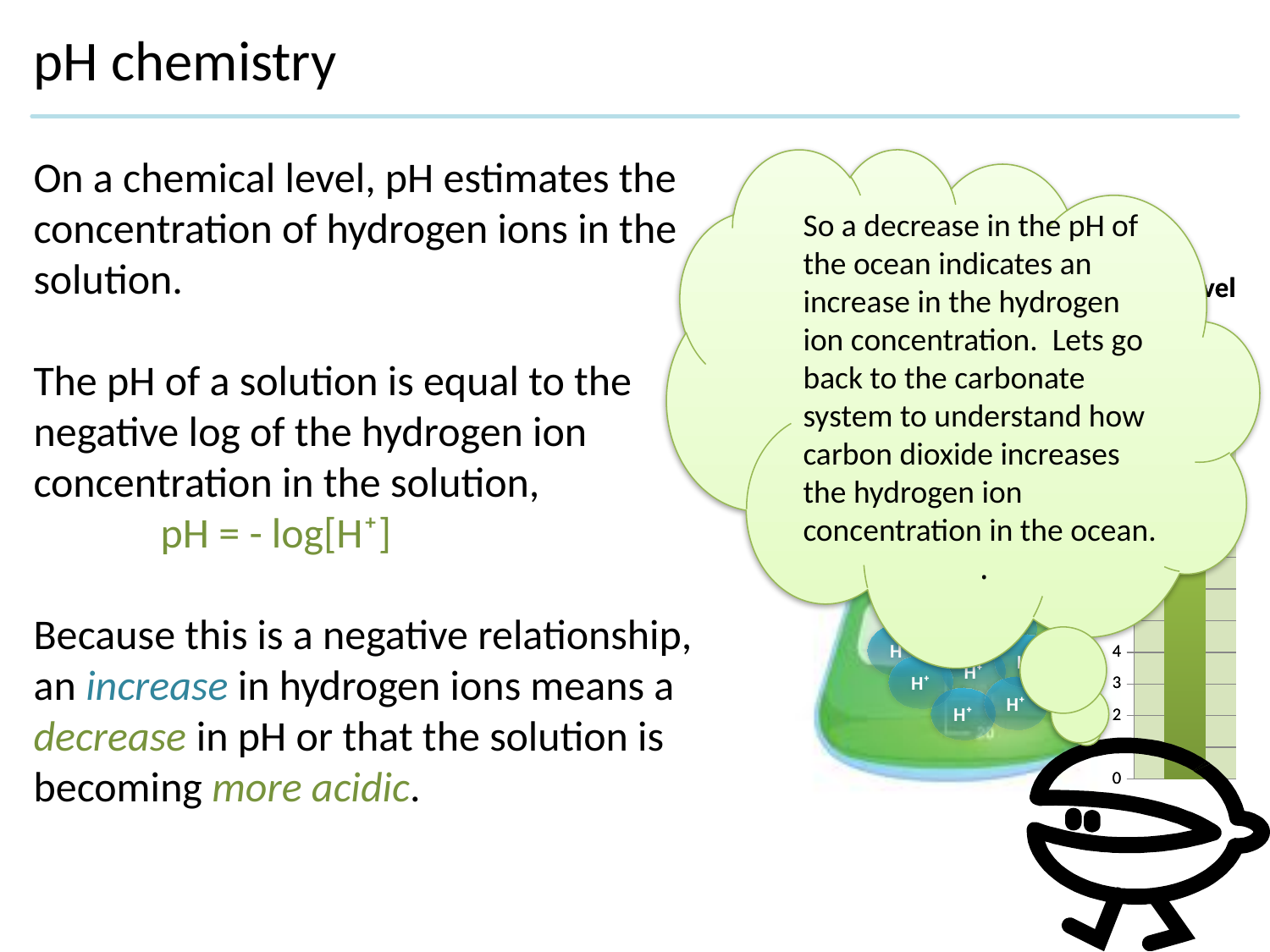
What kind of chart is partially visible on the right side of the slide? bar chart On the partially visible chart on the right, is the value of the visible green bar greater or less than 4? greater On the partially visible chart on the right, what is the lowest tick value shown on the vertical axis? 0